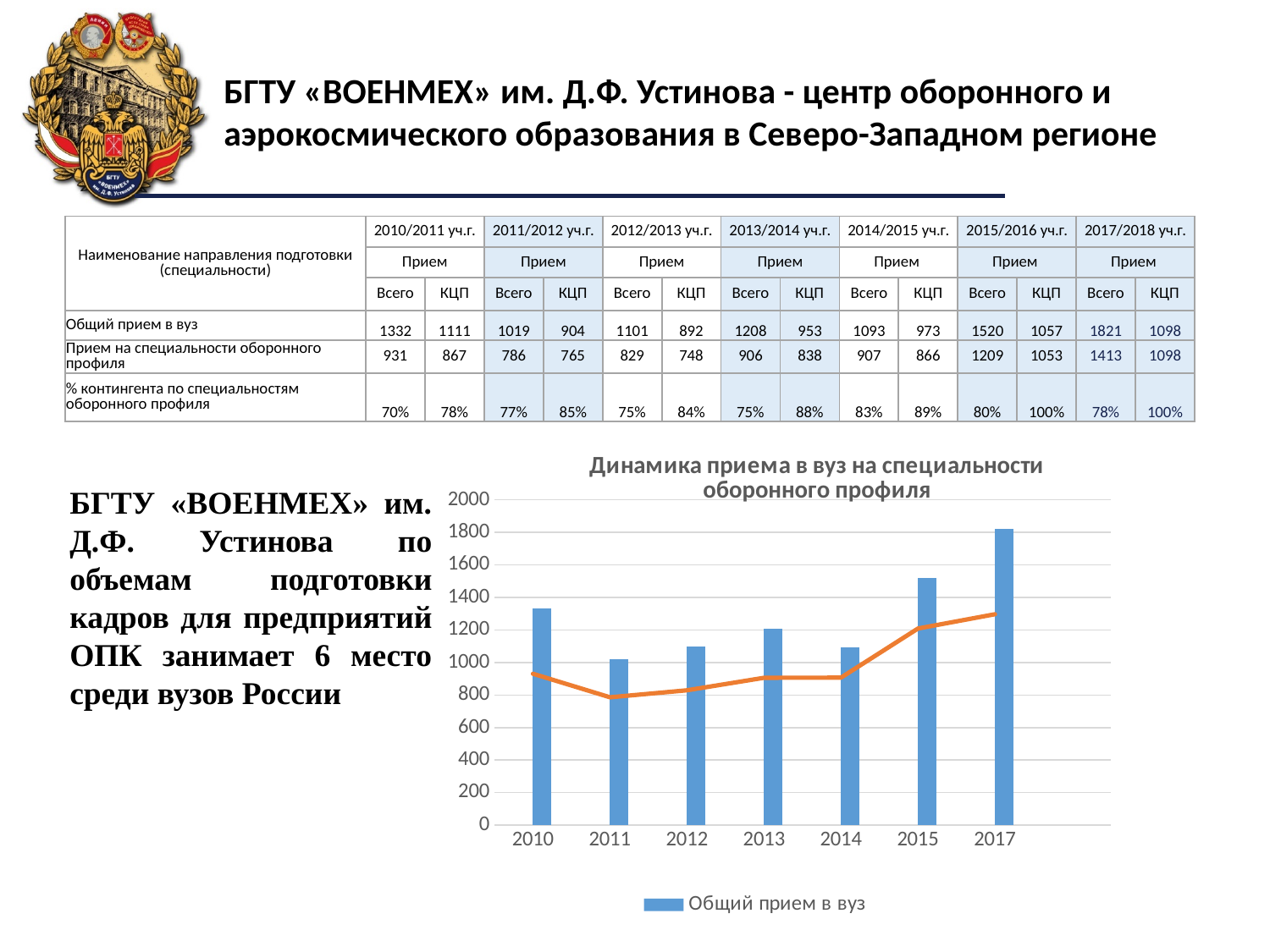
How many series does the chart legend list? 1 Do the bars rise or fall from 2014 to 2017? rise Which bar is taller, 2010 or 2013? 2010 What kind of chart is used to show the series "Общий прием в вуз"? bar chart Is the bar for 2017 greater or less than 1600? greater How many years are shown on the x axis of the chart? 7 Is the bar for 2015 greater or less than 1400? greater What is the legend entry shown below the chart? Общий прием в вуз Which year has the shortest bar in the chart? 2011 Which year has the tallest bar in the chart? 2017 Is the bar for 2011 greater or less than 1200? less What is the title of the chart? Динамика приема в вуз на специальности оборонного профиля